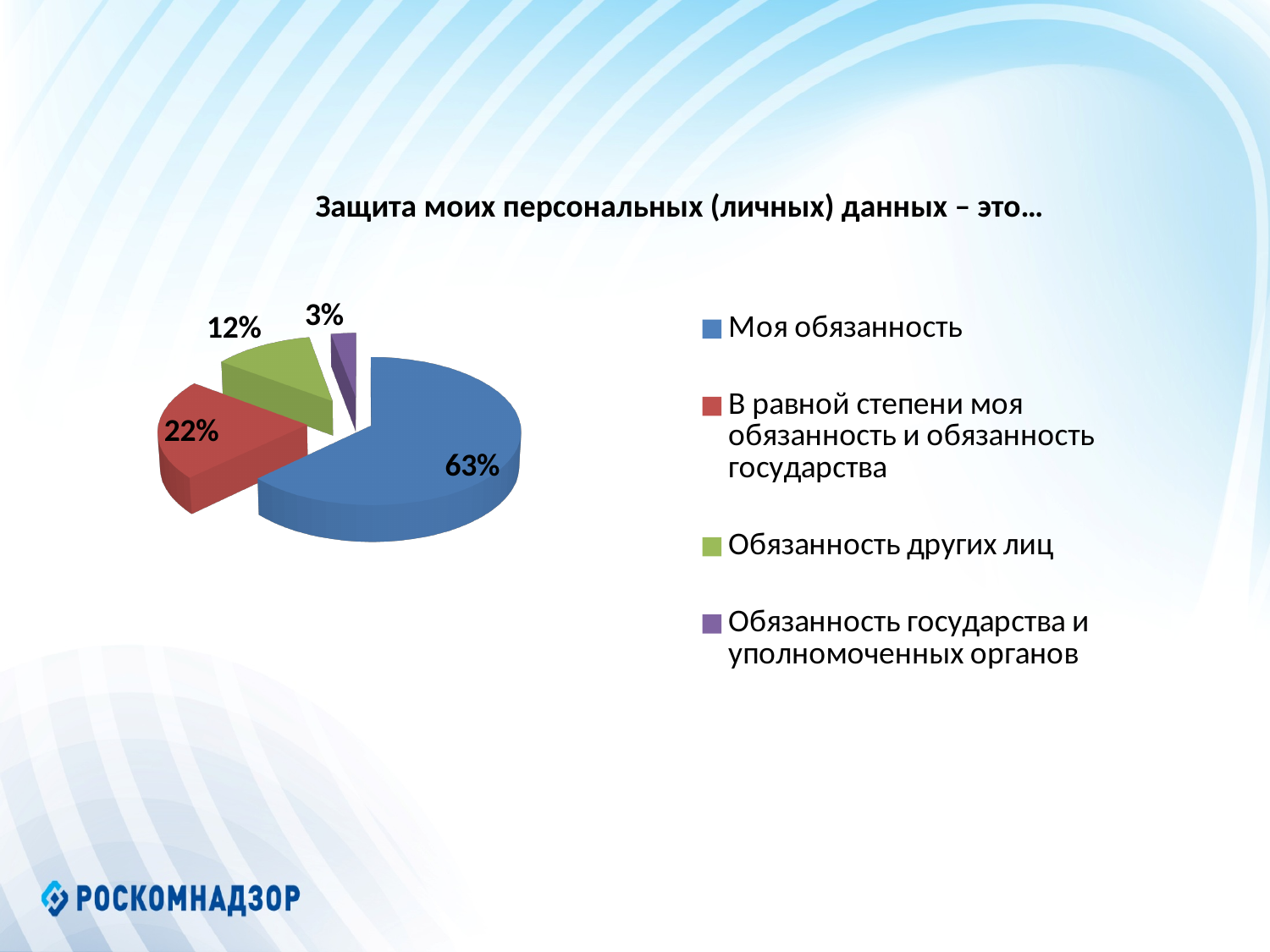
What share of the pie does "Моя обязанность" have? 63% What is the value for "Обязанность других лиц"? 12% How many categories does the pie chart have? 4 What is the value for "В равной степени моя обязанность и обязанность государства"? 22% What is the difference between the values for "Моя обязанность" and "В равной степени моя обязанность и обязанность государства"? 41% What is the title of the chart? Защита моих персональных (личных) данных – это… Which category has the largest slice of the pie? Моя обязанность What is the value for "Обязанность государства и уполномоченных органов"? 3% Which is larger: the value for "Обязанность других лиц" or the value for "Обязанность государства и уполномоченных органов"? Обязанность других лиц Which category has the smallest slice of the pie? Обязанность государства и уполномоченных органов What colour is the slice for "Обязанность других лиц"? Green What kind of chart is shown on the slide? Pie chart